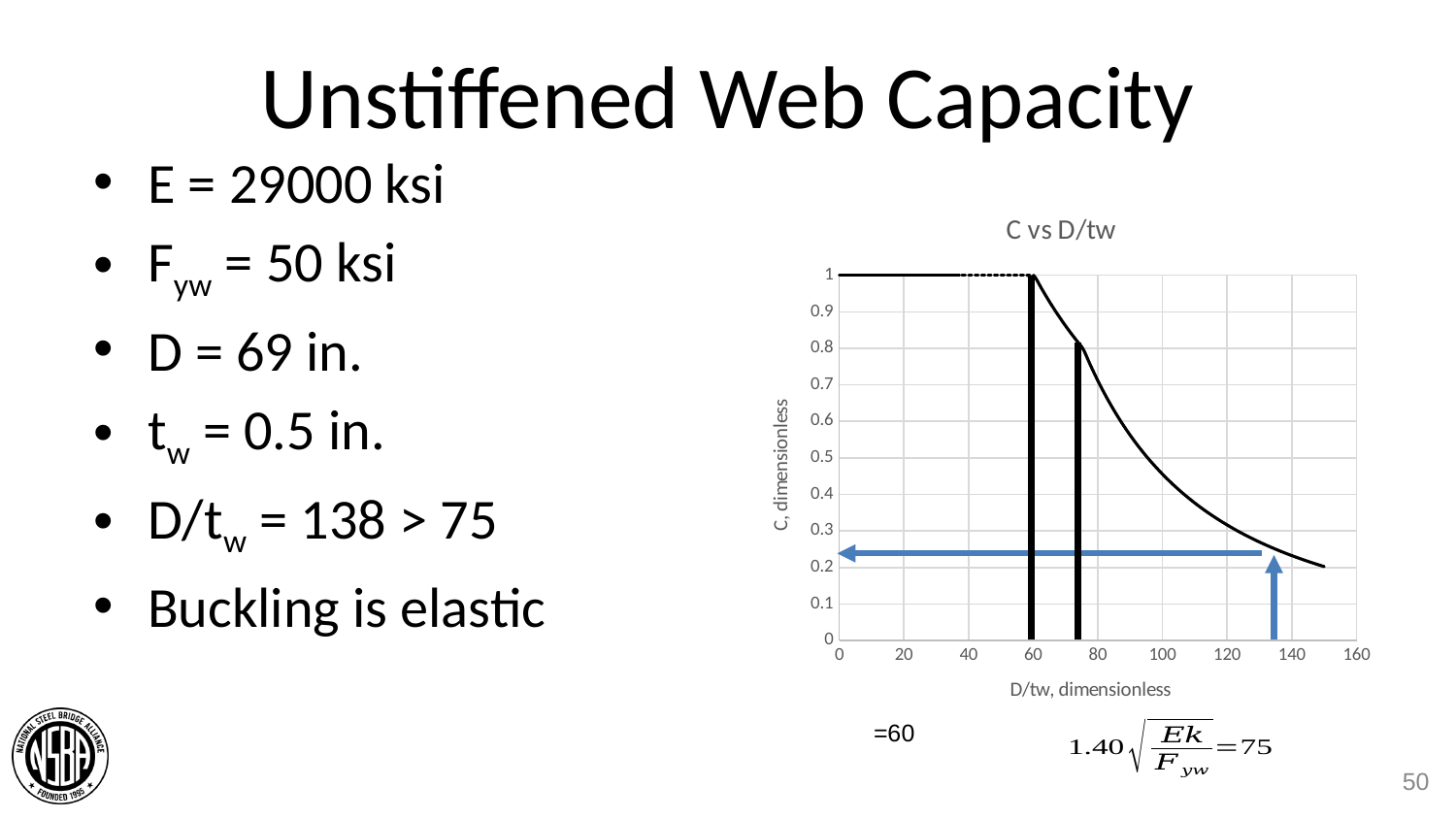
Is the value of C at D/tw = 150 greater or less than 0.5? less Is the value of C at D/tw = 80 greater or less than 0.5? greater Is the value of C at D/tw = 120 greater or less than 0.5? less Does the value of C rise or fall as D/tw increases beyond 60? fall What is the title of the chart? C vs D/tw What is the highest value shown on the vertical axis of the chart? 1 Which has the larger value of C: D/tw = 40 or D/tw = 100? D/tw = 40 What is the label of the vertical axis of the chart? C, dimensionless What kind of chart is shown on the slide? line chart